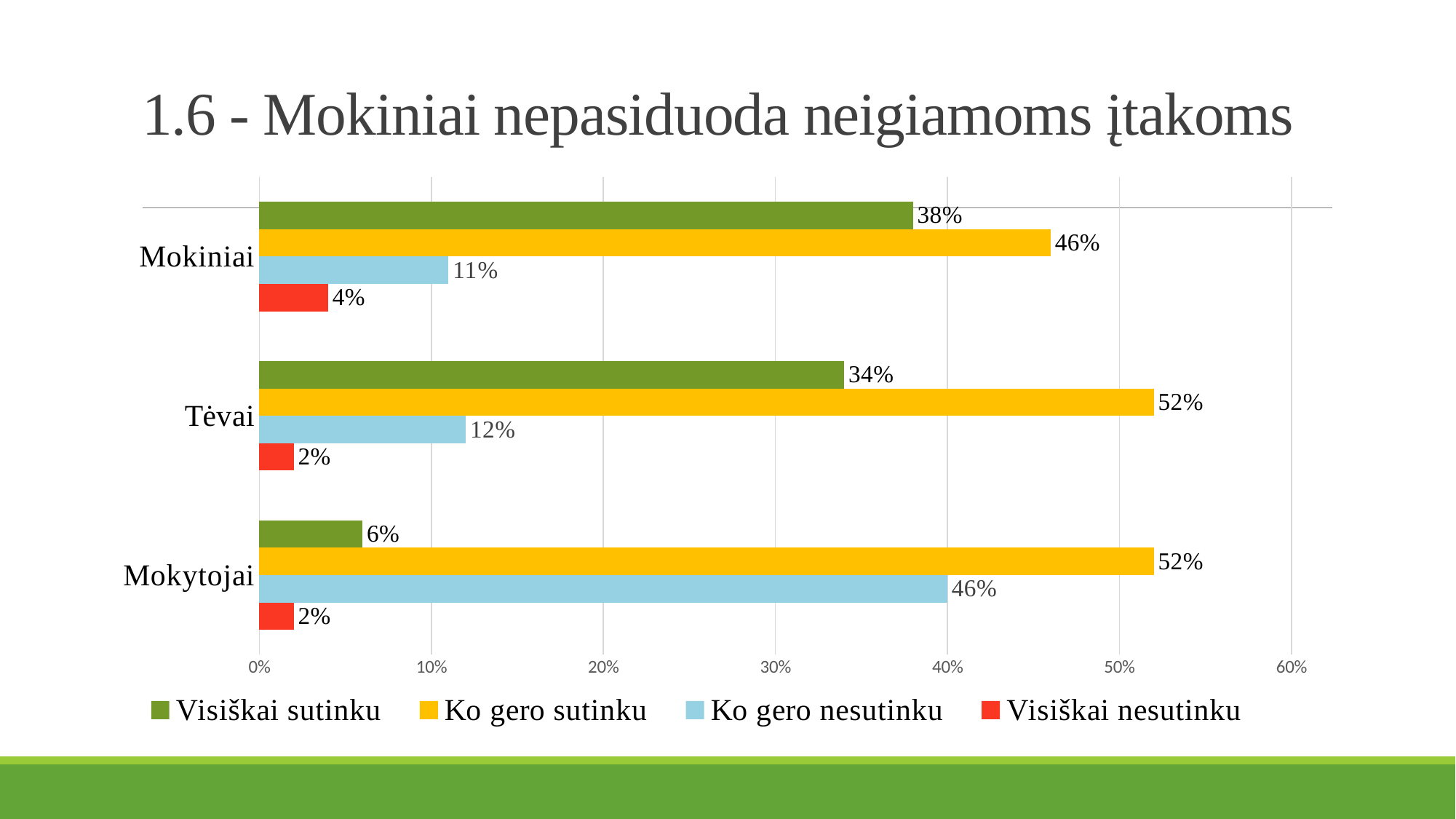
Which category has the lowest value for "Ko gero nesutinku"? Mokiniai What is the title of the chart? 1.6 - Mokiniai nepasiduoda neigiamoms įtakoms Which category has the highest value for "Visiškai sutinku"? Mokiniai What is the value for "Ko gero nesutinku" in the Mokytojai category? 46% What is the value for "Visiškai sutinku" in the Mokiniai category? 38% How many series does the legend list? 4 What kind of chart is shown on the slide? Bar chart What is the difference between the "Ko gero sutinku" values for Tėvai and Mokiniai? 6% How many categories are shown on the vertical axis? 3 Is the value for "Ko gero sutinku" in the Mokytojai category greater or less than 50%? greater Which is larger: "Visiškai sutinku" for Tėvai or "Visiškai sutinku" for Mokytojai? Tėvai What is the value for "Visiškai nesutinku" in the Tėvai category? 2%